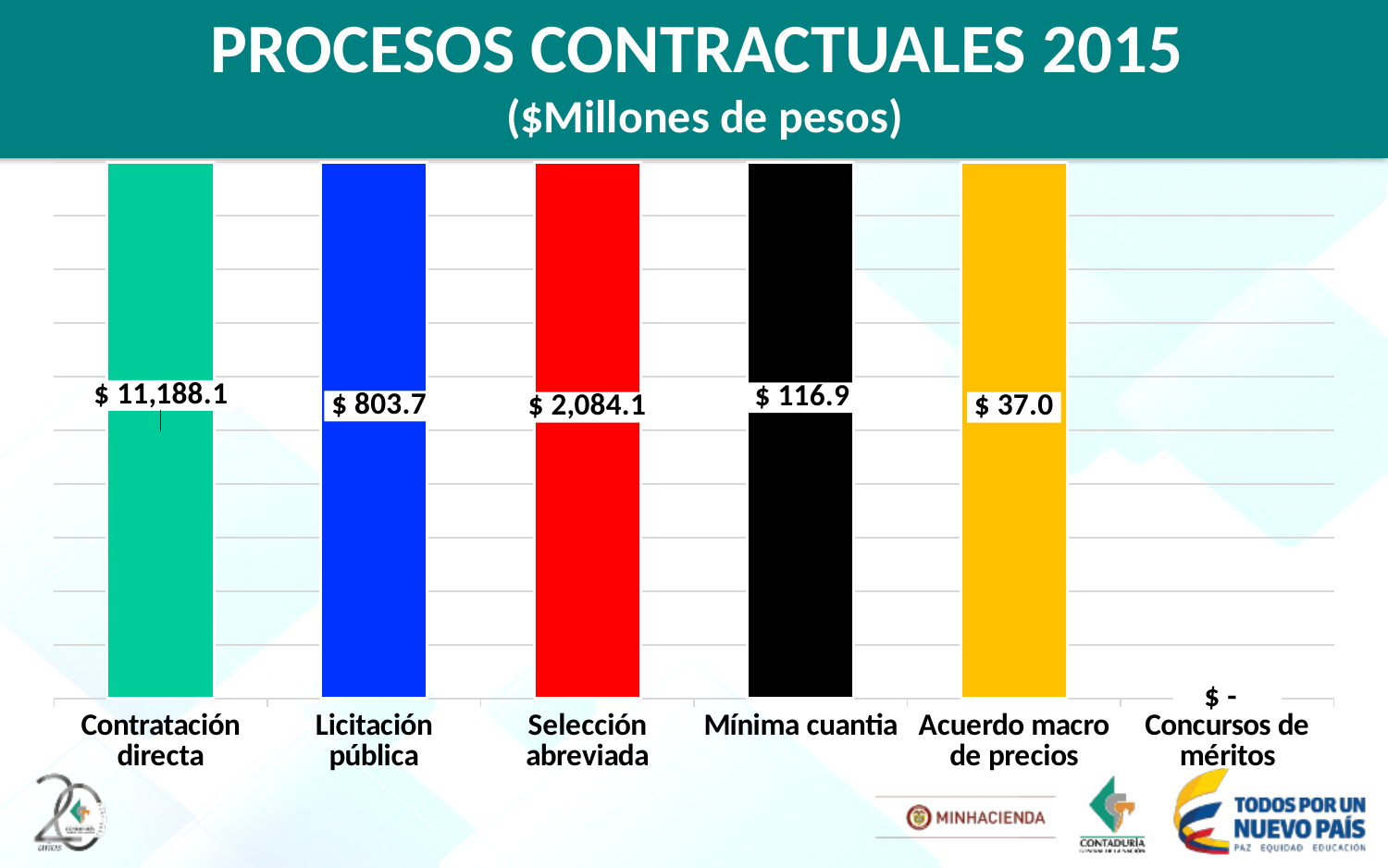
Which category has the highest value? Contratación directa What is the value for Acuerdo macro de precios? $ 37.0 What is the value for Mínima cuantia? $ 116.9 What is the difference between the values for Contratación directa and Selección abreviada? $ 9,104.0 Which category has the lowest value? Concursos de méritos How many categories are shown on the x axis? 6 What is the difference between the values for Licitación pública and Mínima cuantia? $ 686.8 Which is larger, the value for Licitación pública or the value for Selección abreviada? Selección abreviada What is the value for Selección abreviada? $ 2,084.1 What kind of chart is shown on the slide? Bar chart What is the value for Contratación directa? $ 11,188.1 What unit is stated in the chart title? $Millones de pesos